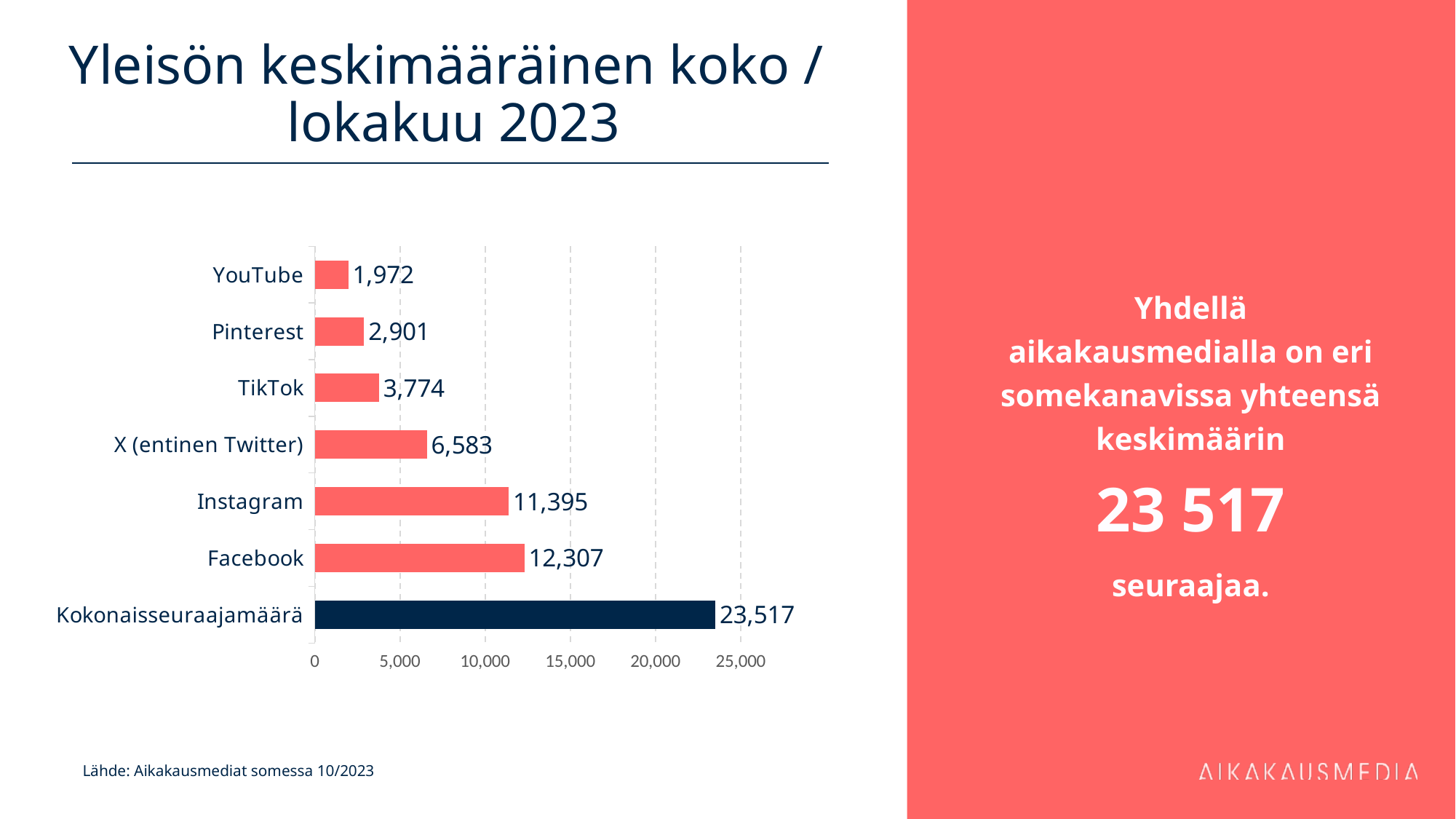
What is the value for Kokonaisseuraajamäärä? 23,517 What is the difference between the values for X (entinen Twitter) and TikTok? 2,809 What kind of chart is shown on the slide? Bar chart What is the value for Instagram? 11,395 Which category has the lowest value? YouTube What is the value for TikTok? 3,774 What is the difference between the values for Facebook and Instagram? 912 Is the value for X (entinen Twitter) greater or less than 5,000? greater What is the title of the chart? Yleisön keskimääräinen koko / lokakuu 2023 Which individual platform (excluding Kokonaisseuraajamäärä) has the highest value? Facebook How many categories are shown in the chart? 7 Which is larger, the value for Pinterest or the value for YouTube? Pinterest